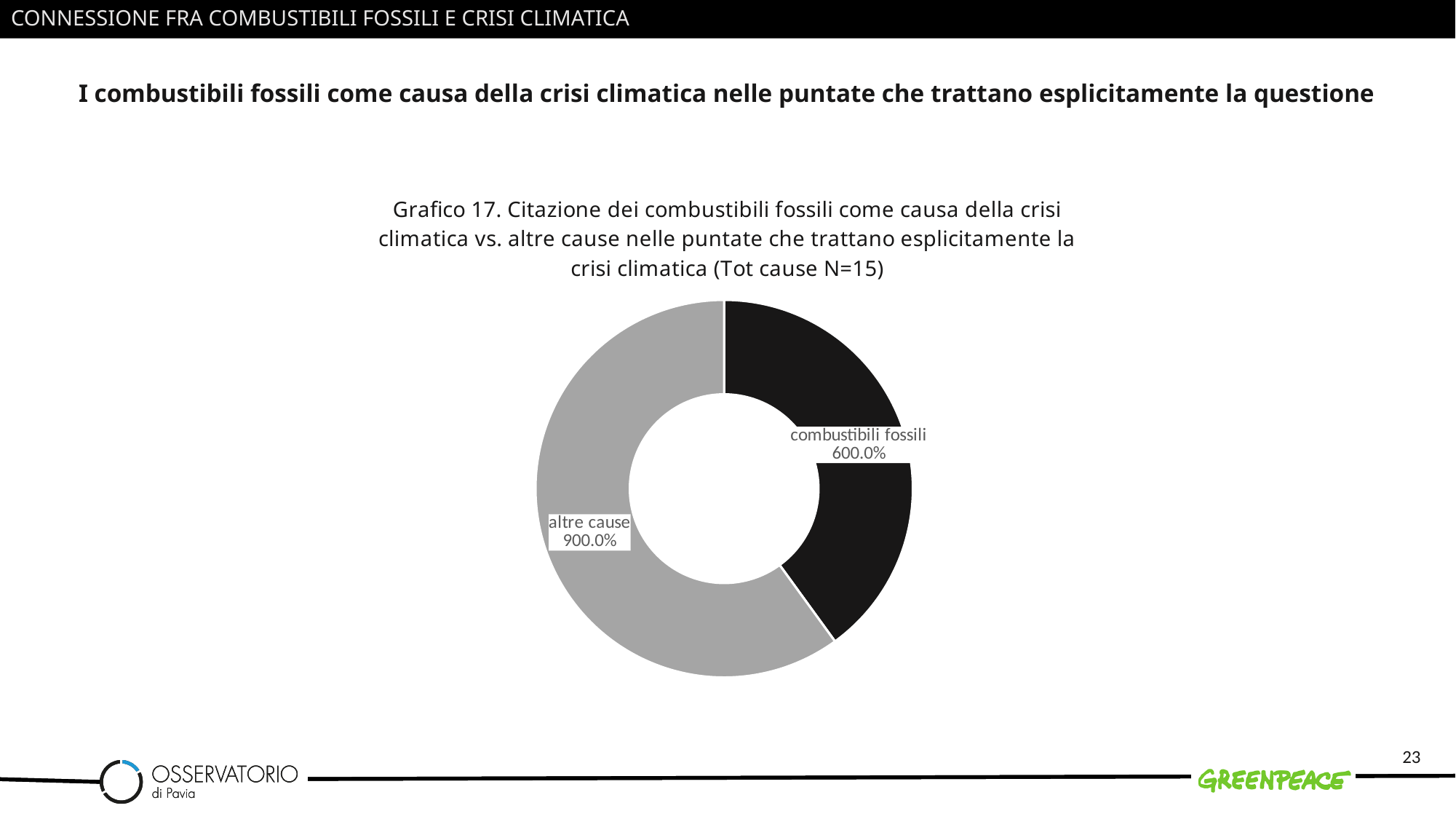
What value is shown for "combustibili fossili"? 600.0% What is the difference between the value for "altre cause" and the value for "combustibili fossili"? 300.0% What is the total number of causes (N) stated in the chart title? 15 Which category has the largest slice? altre cause What colour is the slice for "combustibili fossili"? black Which is larger, the value for "altre cause" or the value for "combustibili fossili"? altre cause What kind of chart is shown on the slide? doughnut chart Which category has the smallest slice? combustibili fossili What value is shown for "altre cause"? 900.0% How many categories are shown in the chart? 2